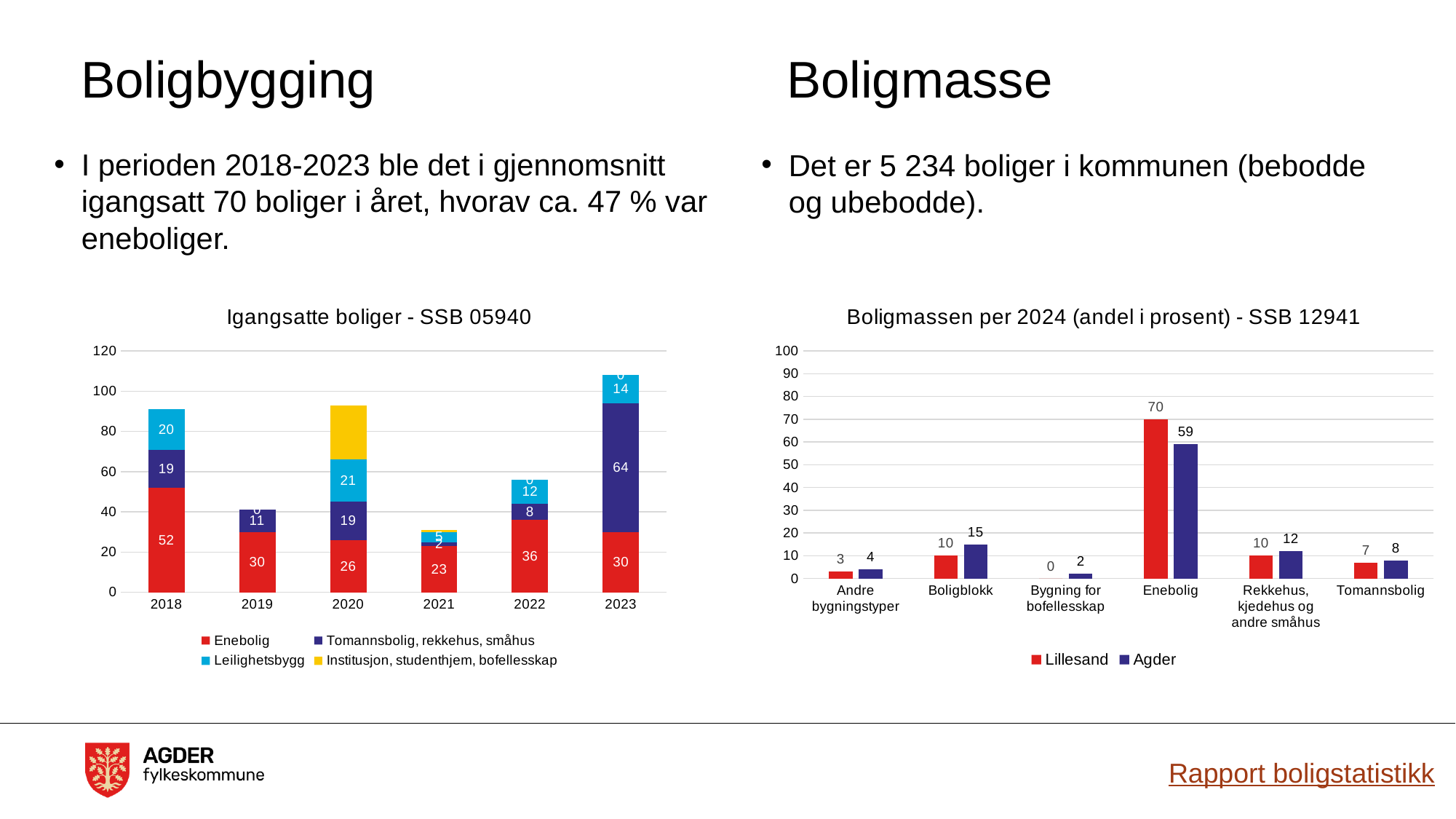
What kind of chart is 'Boligmassen per 2024 (andel i prosent) - SSB 12941'? Bar chart In the chart 'Igangsatte boliger - SSB 05940', what is the Enebolig value for 2018? 52 In the chart 'Boligmassen per 2024 (andel i prosent) - SSB 12941', which category has the lowest Agder value? Bygning for bofellesskap In the chart 'Igangsatte boliger - SSB 05940', which year has the highest Enebolig value? 2018 In the chart 'Igangsatte boliger - SSB 05940', what is the total of the stacked bar for 2023? 108 In the chart 'Boligmassen per 2024 (andel i prosent) - SSB 12941', what is the Lillesand value for Enebolig? 70 In the chart 'Boligmassen per 2024 (andel i prosent) - SSB 12941', how many categories are shown on the x axis? 6 In the chart 'Igangsatte boliger - SSB 05940', how many series does the legend list? 4 In the chart 'Igangsatte boliger - SSB 05940', what is the difference between the Enebolig values for 2022 and 2021? 13 In the chart 'Igangsatte boliger - SSB 05940', is the total for 2020 greater or less than 80? greater In the chart 'Igangsatte boliger - SSB 05940', what is the value for 'Tomannsbolig, rekkehus, småhus' in 2023? 64 In the chart 'Boligmassen per 2024 (andel i prosent) - SSB 12941', what is the difference between the Agder and Lillesand values for Boligblokk? 5